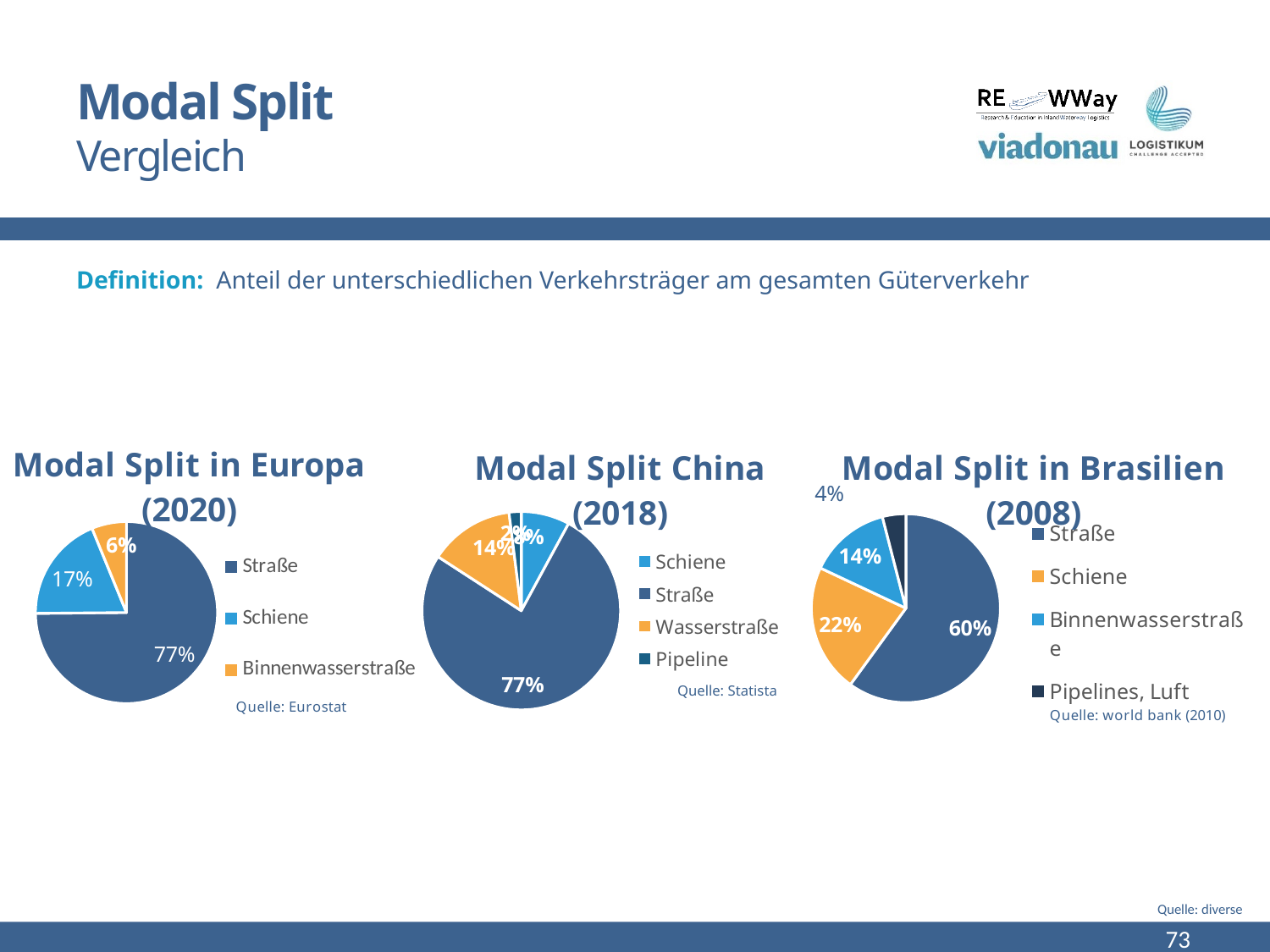
In the Modal Split in Europa (2020) chart, what share does Schiene have? 17% In the Modal Split China (2018) chart, which mode has the largest share? Straße In the Modal Split in Europa (2020) chart, what share does Straße have? 77% What type of chart is the Modal Split in Europa (2020) chart? Pie chart In the Modal Split China (2018) chart, what share does Wasserstraße have? 14% In the Modal Split in Brasilien (2008) chart, how many categories does the legend list? 4 In the Modal Split in Europa (2020) chart, what share does Binnenwasserstraße have? 6% In the Modal Split in Brasilien (2008) chart, which category has the smallest share? Pipelines, Luft Which source is cited below the Modal Split China (2018) chart? Quelle: Statista In the Modal Split in Brasilien (2008) chart, what share does Schiene have? 22% In the Modal Split in Europa (2020) chart, what is the difference between the shares of Schiene and Binnenwasserstraße? 11% In the Modal Split in Brasilien (2008) chart, what share does Binnenwasserstraße have? 14%